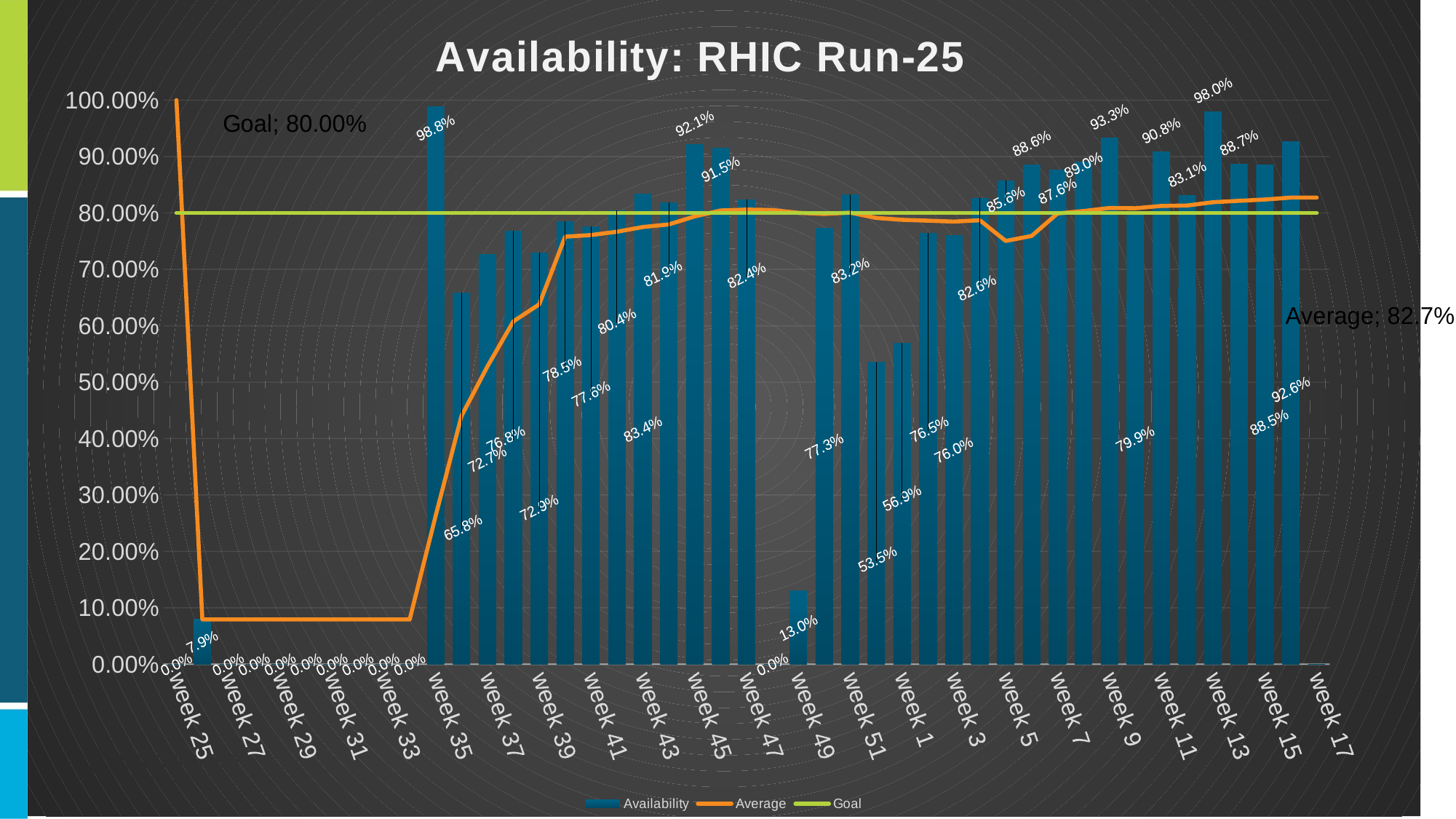
Which legend entry is drawn as a green line? Goal What is the title of the chart? Availability: RHIC Run-25 What is the Availability value for week 49? 13.0% What is the Average value shown on the chart? 82.7% Does the Average line rise or fall between week 33 and week 37? rise Which has the higher Availability, week 35 or week 49? week 35 What kind of chart is used to show the Availability series? bar chart Is the Availability value for week 25 greater or less than 10.00%? less How many series does the legend list? 3 What is the Availability value for week 35? 98.8% What is the Goal value shown on the chart? 80.00% What is the highest Availability value labelled on the chart? 98.8%